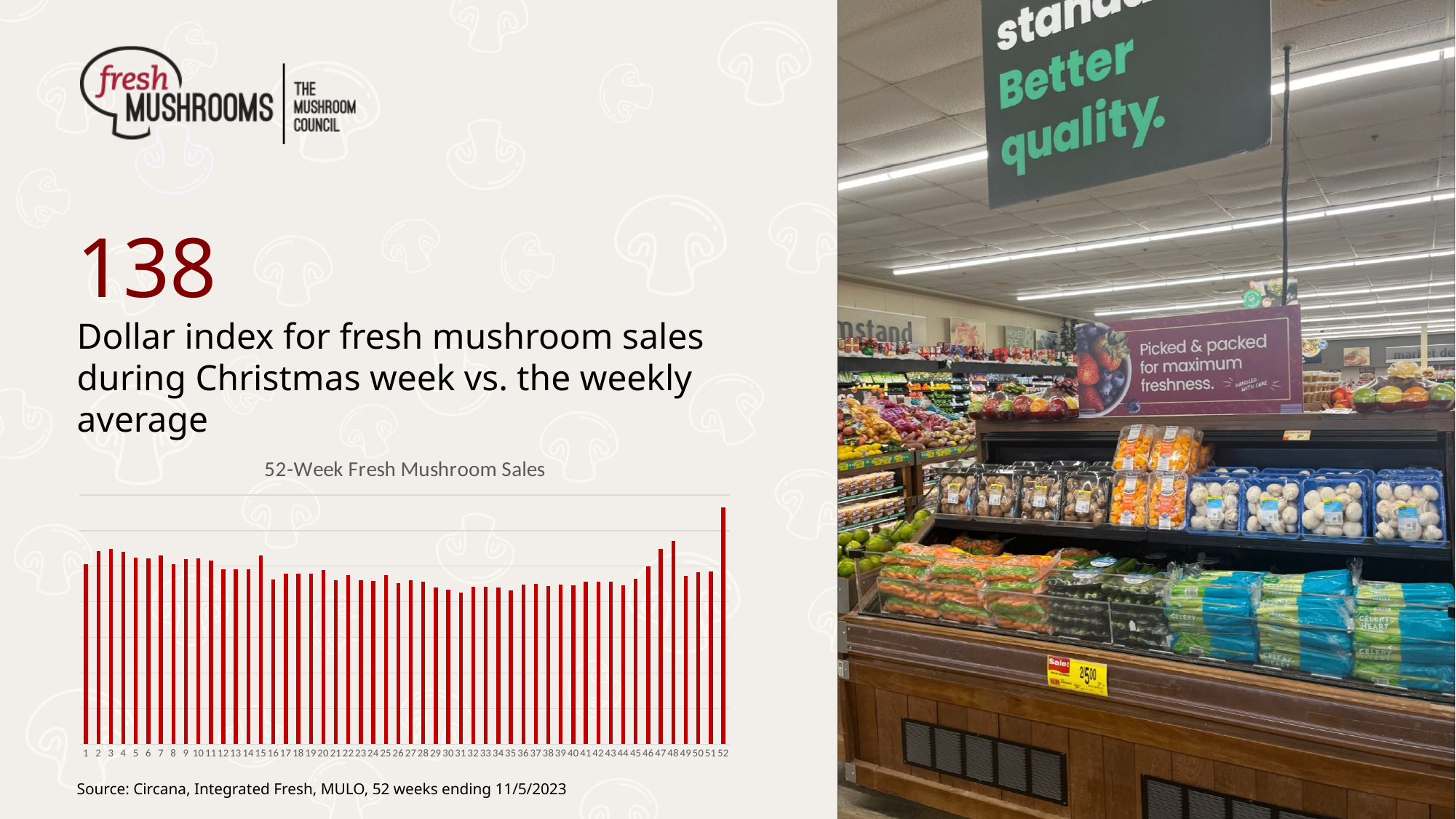
On the "52-Week Fresh Mushroom Sales" chart, do the bars generally rise or fall from week 40 to week 52? Rise On the "52-Week Fresh Mushroom Sales" chart, which bar is taller, week 48 or week 49? Week 48 On the "52-Week Fresh Mushroom Sales" chart, which bar is taller, week 2 or week 31? Week 2 What kind of chart is the "52-Week Fresh Mushroom Sales" chart? Bar chart What is the title of the chart on the slide? 52-Week Fresh Mushroom Sales How many weeks are plotted on the "52-Week Fresh Mushroom Sales" chart? 52 On the "52-Week Fresh Mushroom Sales" chart, which bar is taller, week 15 or week 16? Week 15 Which week has the highest bar on the "52-Week Fresh Mushroom Sales" chart? Week 52 On the "52-Week Fresh Mushroom Sales" chart, do the bars generally rise or fall from week 1 to week 31? Fall What colour are the bars on the "52-Week Fresh Mushroom Sales" chart? Red